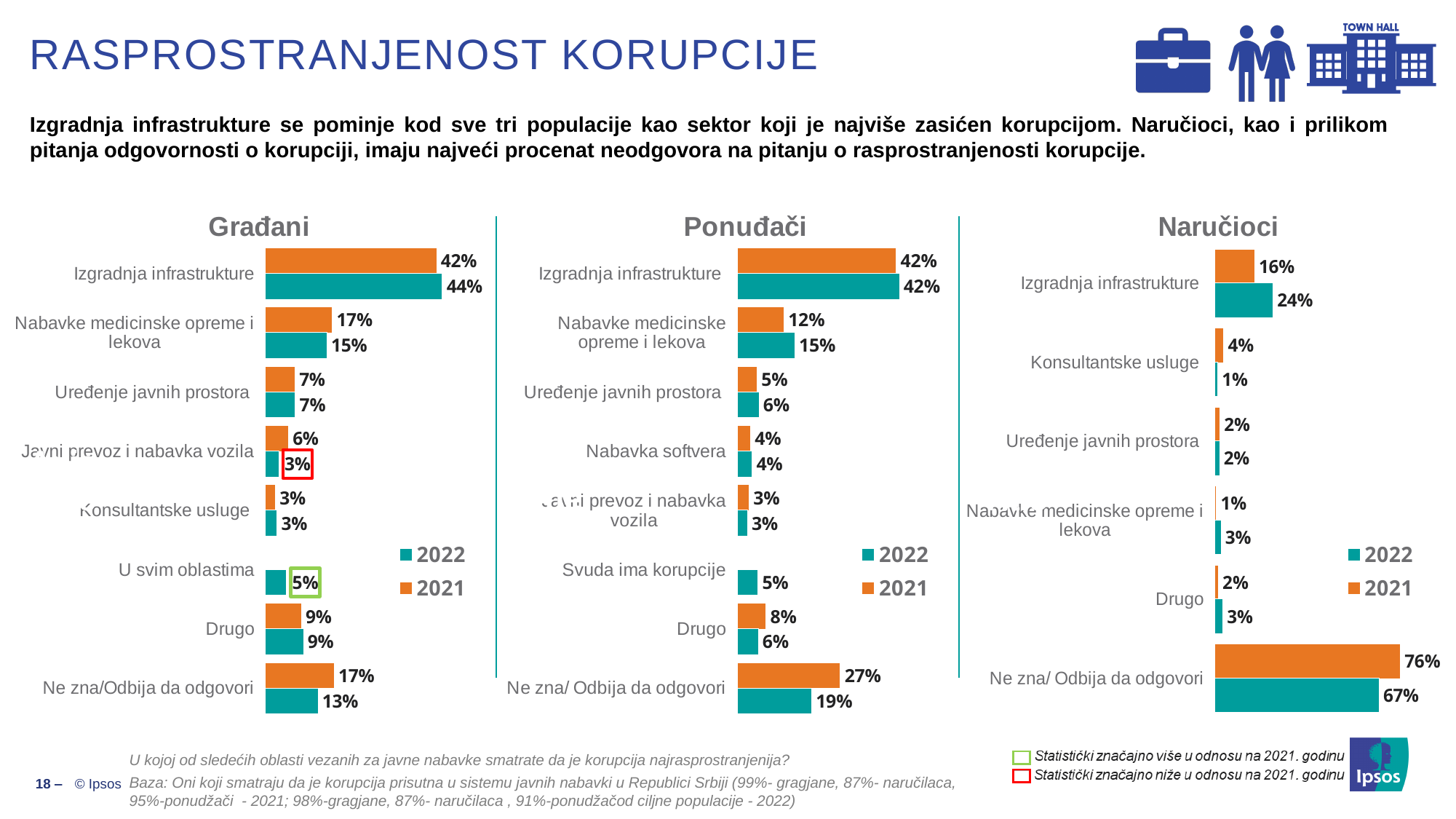
How many categories are shown in the Naručioci chart? 6 What type of chart is the Ponuđači chart? Bar chart In the Građani chart, which is larger for Javni prevoz i nabavka vozila: the 2021 value or the 2022 value? 2021 In the Građani chart, what is the 2022 value for Izgradnja infrastrukture? 44% In the Ponuđači chart, what is the 2022 value for Nabavke medicinske opreme i lekova? 15% How many series does the legend list in the Građani chart? 2 In the Naručioci chart, what is the difference between the 2022 and 2021 values for Izgradnja infrastrukture? 8% In the Ponuđači chart, what is the difference between the 2021 and 2022 values for Ne zna/ Odbija da odgovori? 8% In the Građani chart, what is the 2021 value for Ne zna/Odbija da odgovori? 17% In the Ponuđači chart, which category has the highest 2021 value? Izgradnja infrastrukture In the Naručioci chart, which category has the highest 2022 value? Ne zna/ Odbija da odgovori In the Naručioci chart, what is the 2021 value for Ne zna/ Odbija da odgovori? 76%